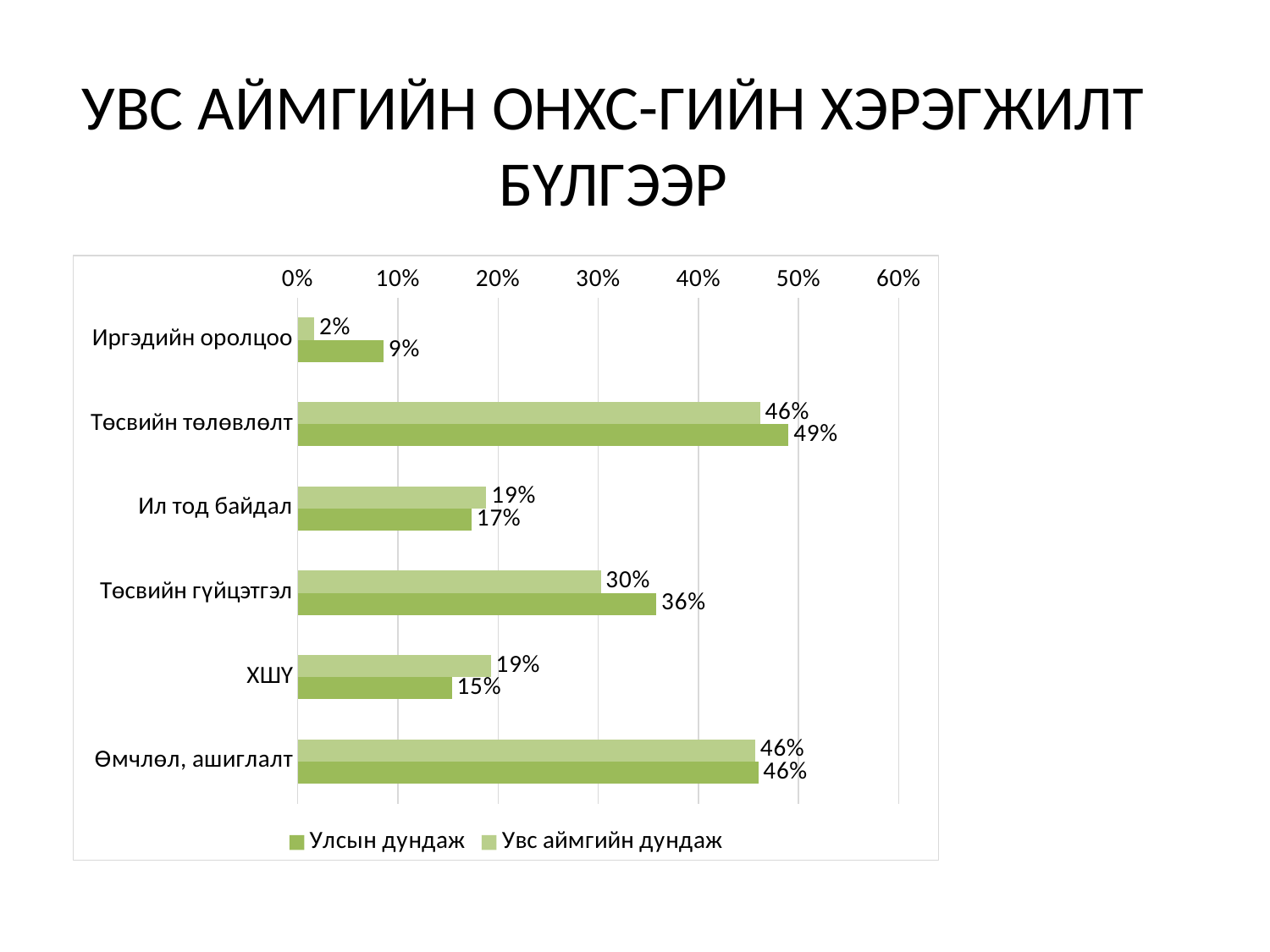
Which category has the lowest value for Увс аймгийн дундаж? Иргэдийн оролцоо For ХШҮ, which is larger: Улсын дундаж or Увс аймгийн дундаж? Увс аймгийн дундаж What is the title of the chart on the slide? УВС АЙМГИЙН ОНХС-ГИЙН ХЭРЭГЖИЛТ БҮЛГЭЭР What is the value of Увс аймгийн дундаж for Төсвийн гүйцэтгэл? 30% What is the value of Улсын дундаж for Төсвийн төлөвлөлт? 49% Which category has the highest value for Улсын дундаж? Төсвийн төлөвлөлт What kind of chart is shown on the slide? bar chart How many categories are shown on the chart? 6 What is the value of Увс аймгийн дундаж for Иргэдийн оролцоо? 2% Is the value of Улсын дундаж for Ил тод байдал greater or less than 20%? less What is the difference between Улсын дундаж and Увс аймгийн дундаж for Төсвийн гүйцэтгэл? 6% How many series does the legend list? 2